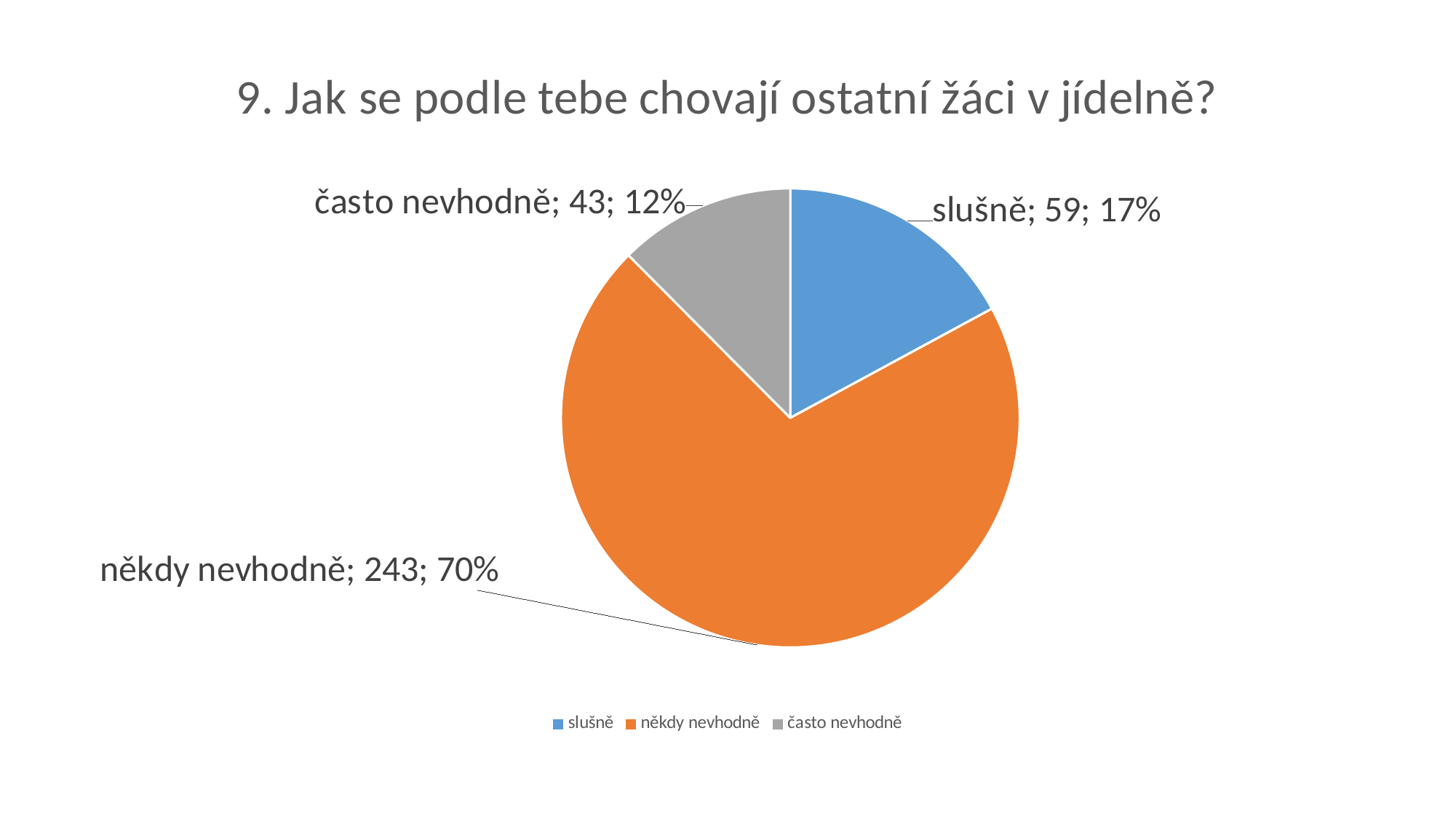
What kind of chart is shown on the slide? pie chart Which category has the largest slice? někdy nevhodně What share of the pie does 'často nevhodně' represent? 12% What is the count for 'někdy nevhodně'? 243 What share of the pie does 'někdy nevhodně' represent? 70% How many entries does the legend list? 3 How many slices does the pie chart have? 3 What is the count for 'často nevhodně'? 43 What is the title of the chart? 9. Jak se podle tebe chovají ostatní žáci v jídelně? What is the count for 'slušně'? 59 What is the difference between the counts for 'slušně' and 'často nevhodně'? 16 Which category has the smallest slice? často nevhodně